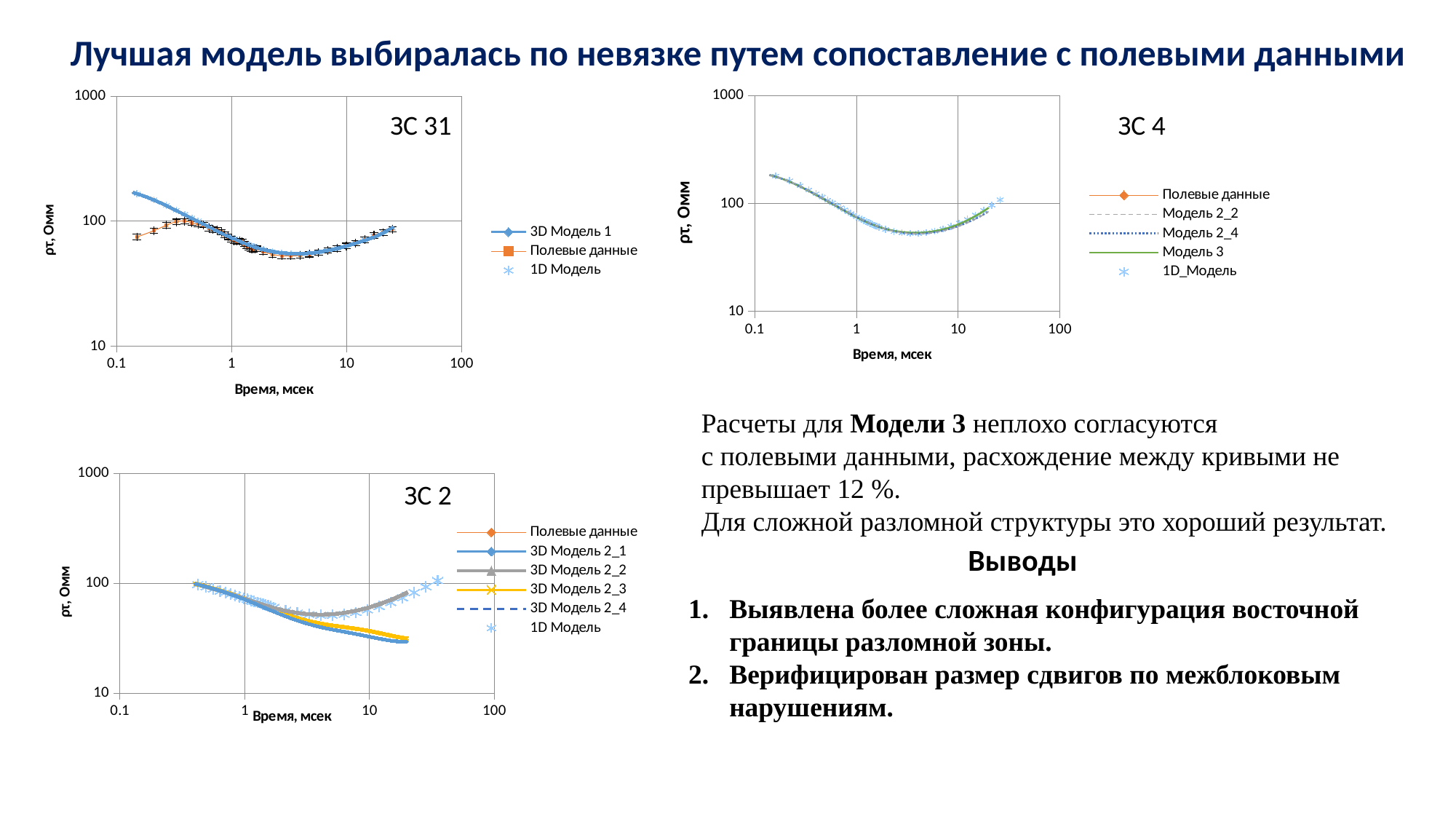
In the ЗС 31 chart, is the lowest point of the 3D Модель 1 curve greater or less than 10? greater How many series does the legend of the ЗС 2 chart list? 6 In the ЗС 2 chart, at around 20 мсек, which series has the larger value: 3D Модель 2_2 or 3D Модель 2_1? 3D Модель 2_2 In the ЗС 4 chart, is the value of the curves at the left end (near 0.1 мсек) greater or less than 100? greater What is the label of the x axis on the ЗС 2 chart? Время, мсек In the ЗС 4 chart, is the value of the curves at 1 мсек greater or less than 100? less How many series does the legend of the ЗС 4 chart list? 5 What kind of chart is the ЗС 31 chart? line chart In the ЗС 4 chart, do the curves rise or fall between 0.1 мсек and 1 мсек? fall How many series does the legend of the ЗС 31 chart list? 3 What is the label of the y axis on the ЗС 31 chart? ρт, Омм